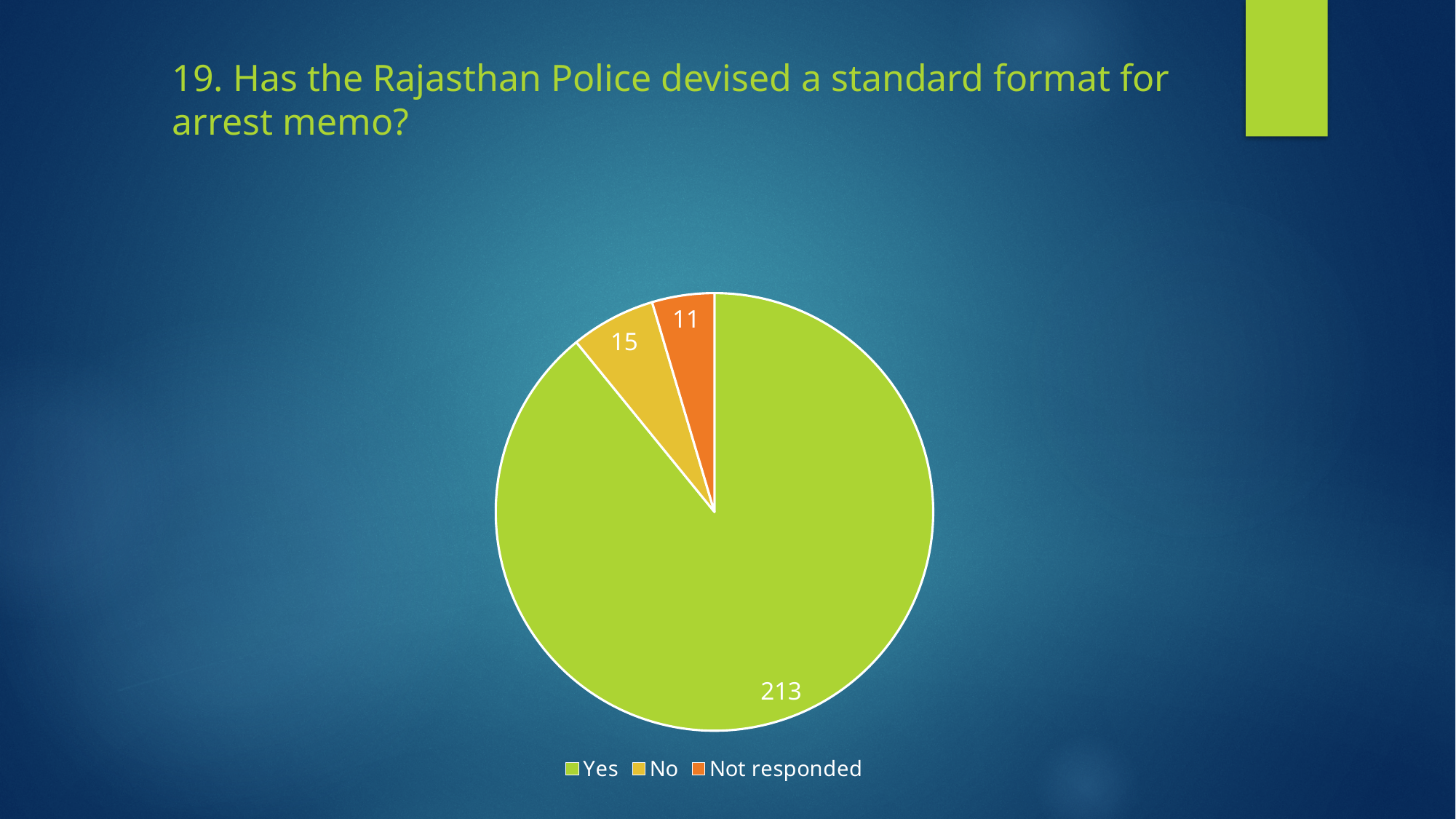
What is the total of all slices in the pie chart? 239 Which colour represents Not responded in the pie chart? Orange Which category has the largest slice of the pie chart? Yes Which is larger, the value for No or the value for Not responded? No What is the value for No in the pie chart? 15 What is the difference between the values for Yes and No? 198 How many categories does the pie chart show? 3 Which category has the smallest slice of the pie chart? Not responded What is the value for Yes in the pie chart? 213 What kind of chart is shown on the slide? Pie chart What is the value for Not responded in the pie chart? 11 What is the difference between the values for No and Not responded? 4